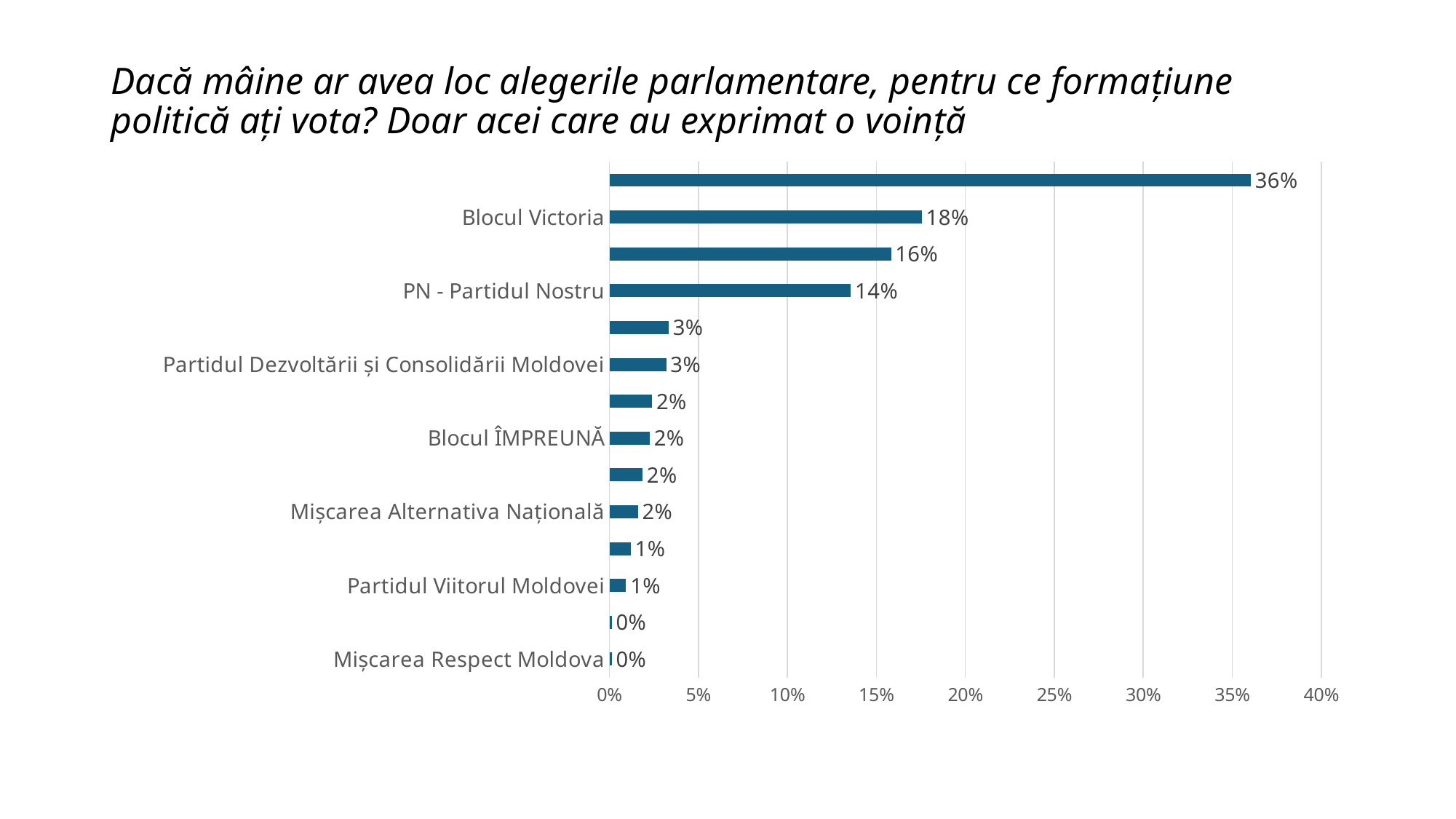
What is the largest value shown by any bar in the chart? 36% What is the value for Mișcarea Respect Moldova? 0% What is the value for Blocul ÎMPREUNĂ? 2% What is the highest value shown on the horizontal axis of the chart? 40% What is the value for Partidul Viitorul Moldovei? 1% What is the value for PN - Partidul Nostru? 14% What is the value for Blocul Victoria? 18% What is the value for Partidul Dezvoltării și Consolidării Moldovei? 3% What kind of chart is shown on the slide? bar chart Which has a larger value, Blocul Victoria or Partidul Dezvoltării și Consolidării Moldovei? Blocul Victoria How many bars are plotted in the chart? 14 What is the difference between the values for Blocul Victoria and PN - Partidul Nostru? 4%